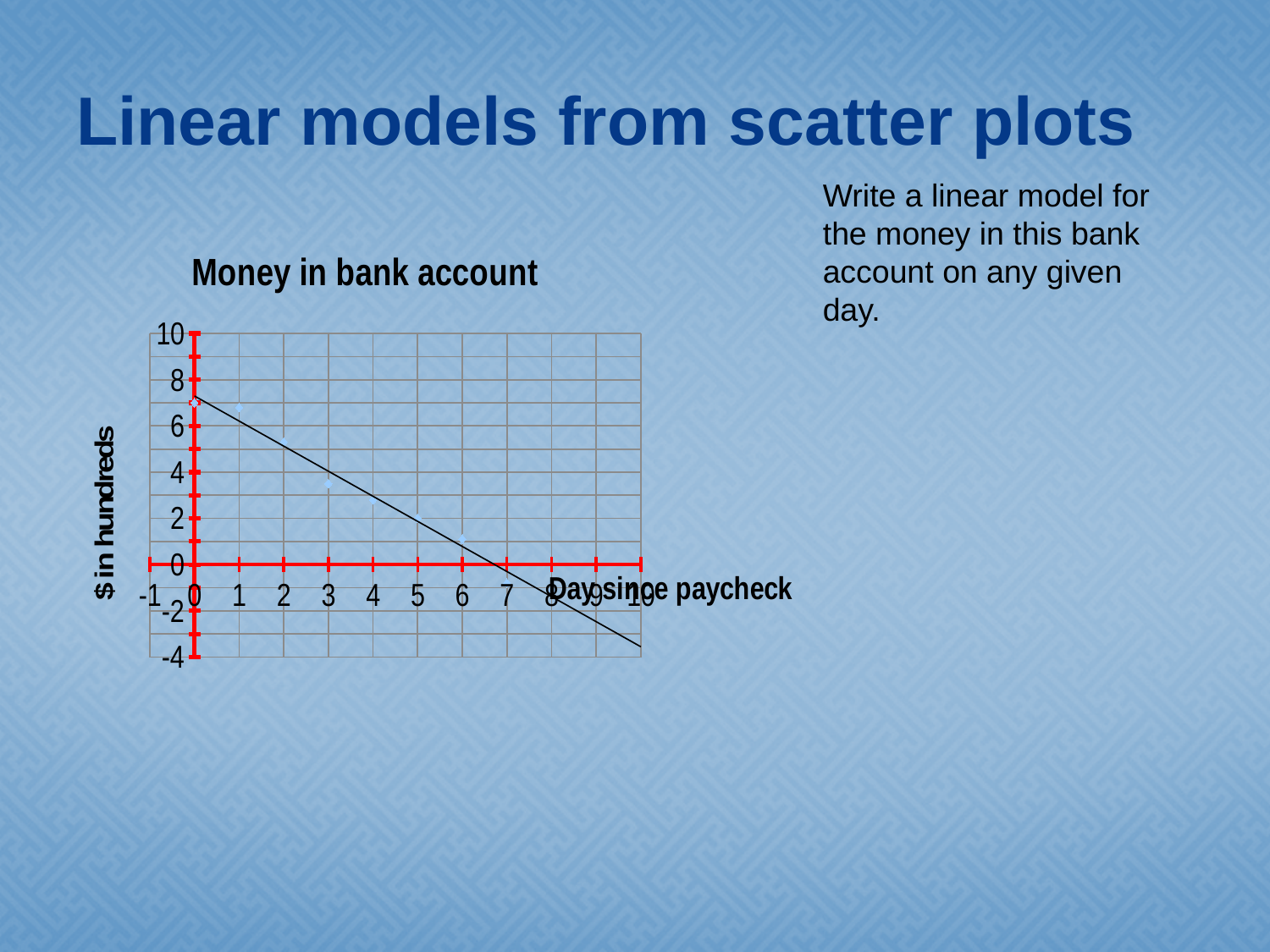
Is the value at day 3 greater or less than 2? greater What is the label of the y axis? $ in hundreds What is the title of the chart? Money in bank account Is the value at day 4 greater or less than 4? less At which day is the plotted value highest? 0 Do the plotted values rise or fall as the days since paycheck increase? fall Is the value at day 6 greater or less than 2? less What kind of chart is shown on the slide? scatter plot Which is larger, the value at day 1 or the value at day 5? day 1